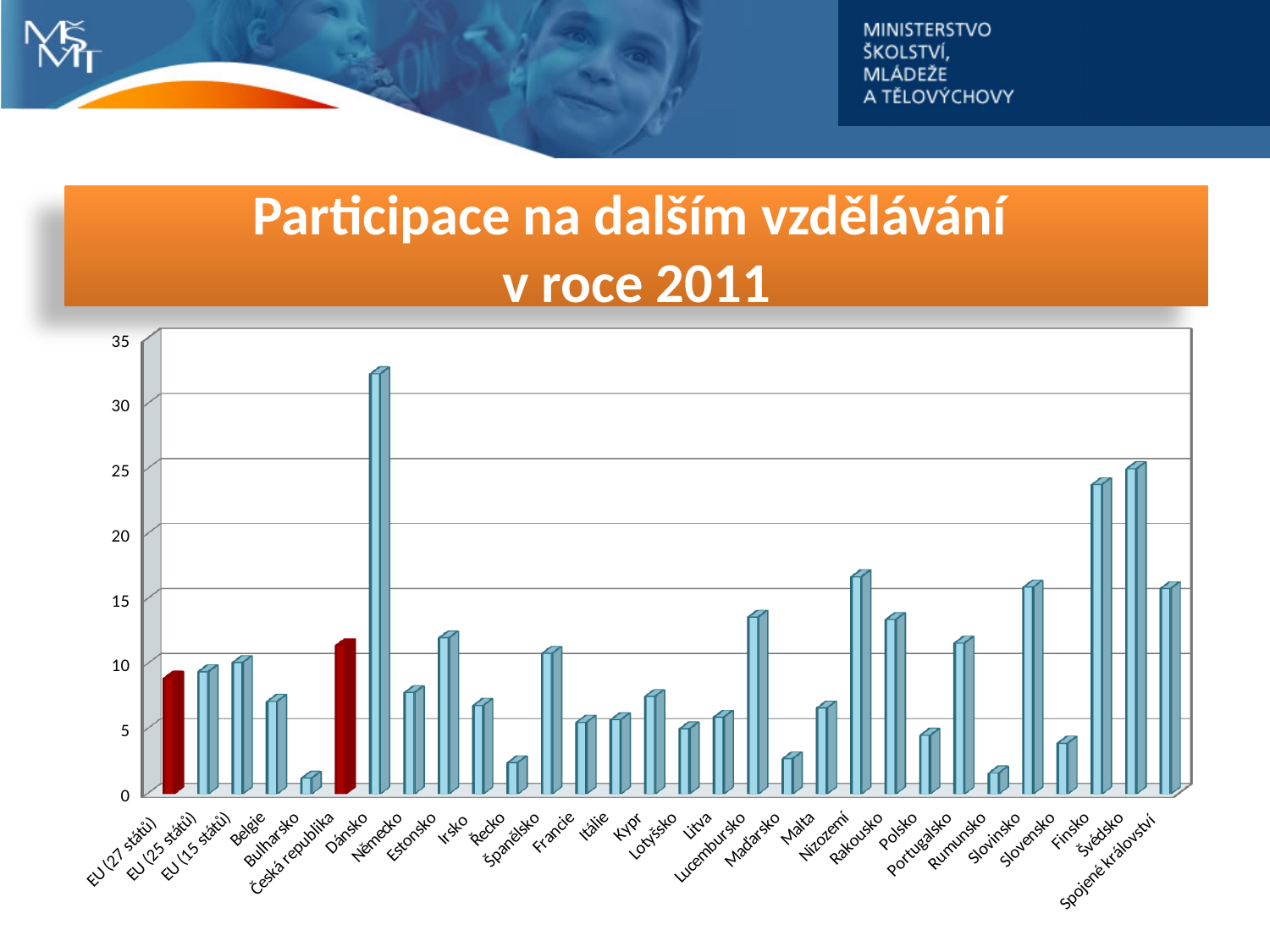
Is the value for Bulharsko greater or less than 5? less Which has a larger value, Dánsko or Švédsko? Dánsko Is the value for Dánsko greater or less than 30? greater Is the value for Řecko greater or less than 5? less What kind of chart is shown on the slide? bar chart Which two categories are drawn with dark red bars instead of light blue? EU (27 států) and Česká republika What is the title of the chart? Participace na dalším vzdělávání v roce 2011 Which category has the highest value in the chart? Dánsko How many categories are shown on the x axis of the chart? 30 Which has a larger value, Česká republika or EU (27 států)? Česká republika